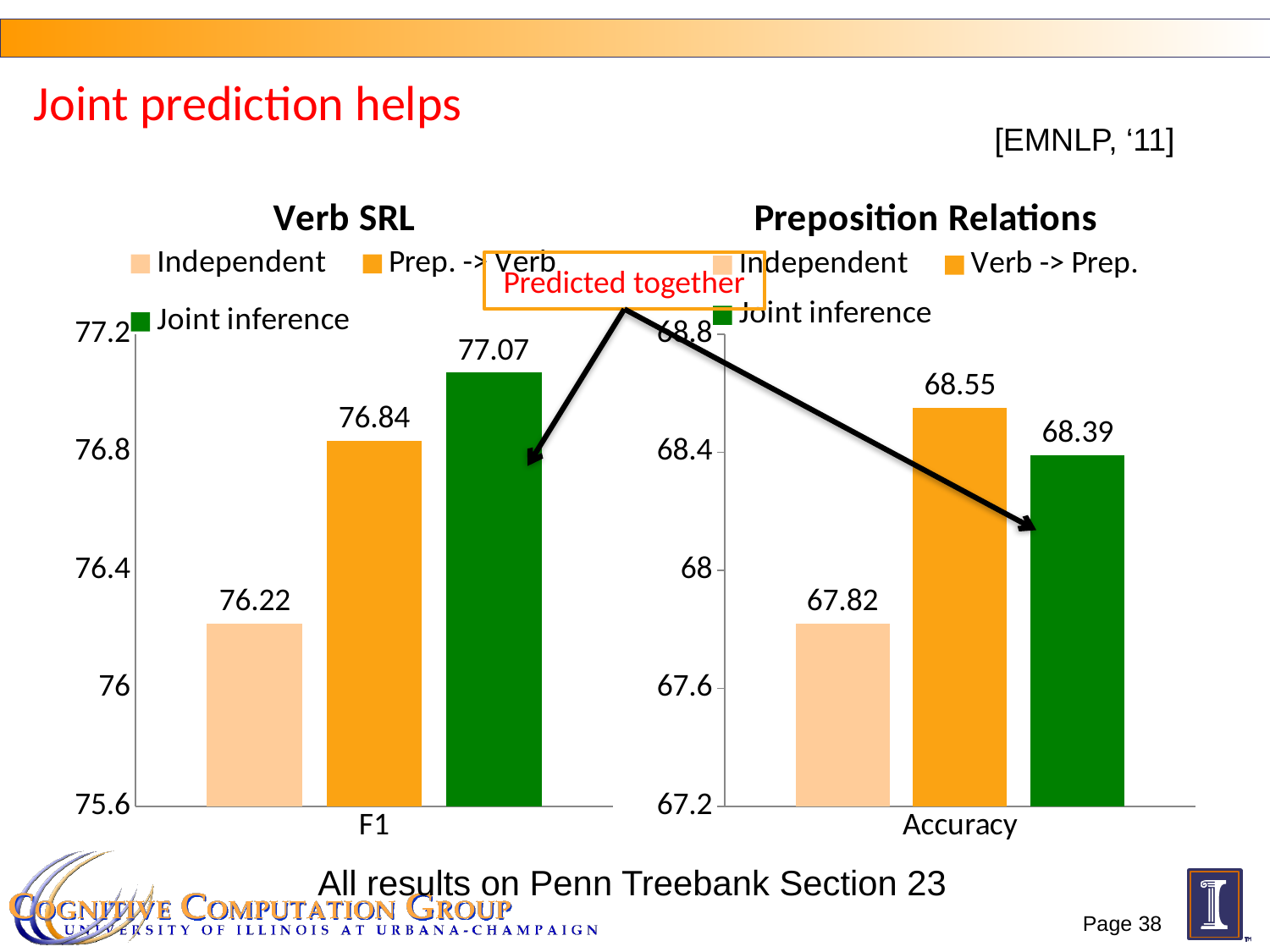
In the Preposition Relations chart, what is the Accuracy value for Joint inference? 68.39 In the Verb SRL chart, which series has the highest F1? Joint inference In the Verb SRL chart, what is the F1 value for Joint inference? 77.07 What kind of chart is the Verb SRL chart? Bar chart In the Preposition Relations chart, what is the difference in Accuracy between Verb -> Prep. and Independent? 0.73 In the Preposition Relations chart, what is the Accuracy value for Verb -> Prep.? 68.55 In the Verb SRL chart, what is the F1 value for Independent? 76.22 In the Preposition Relations chart, which series has the lowest Accuracy? Independent In the Verb SRL chart, what is the difference in F1 between Joint inference and Independent? 0.85 How many series does the legend of the Preposition Relations chart list? 3 In the Verb SRL chart, which is larger: the F1 for Prep. -> Verb or for Independent? Prep. -> Verb In the Preposition Relations chart, which series has the highest Accuracy? Verb -> Prep.